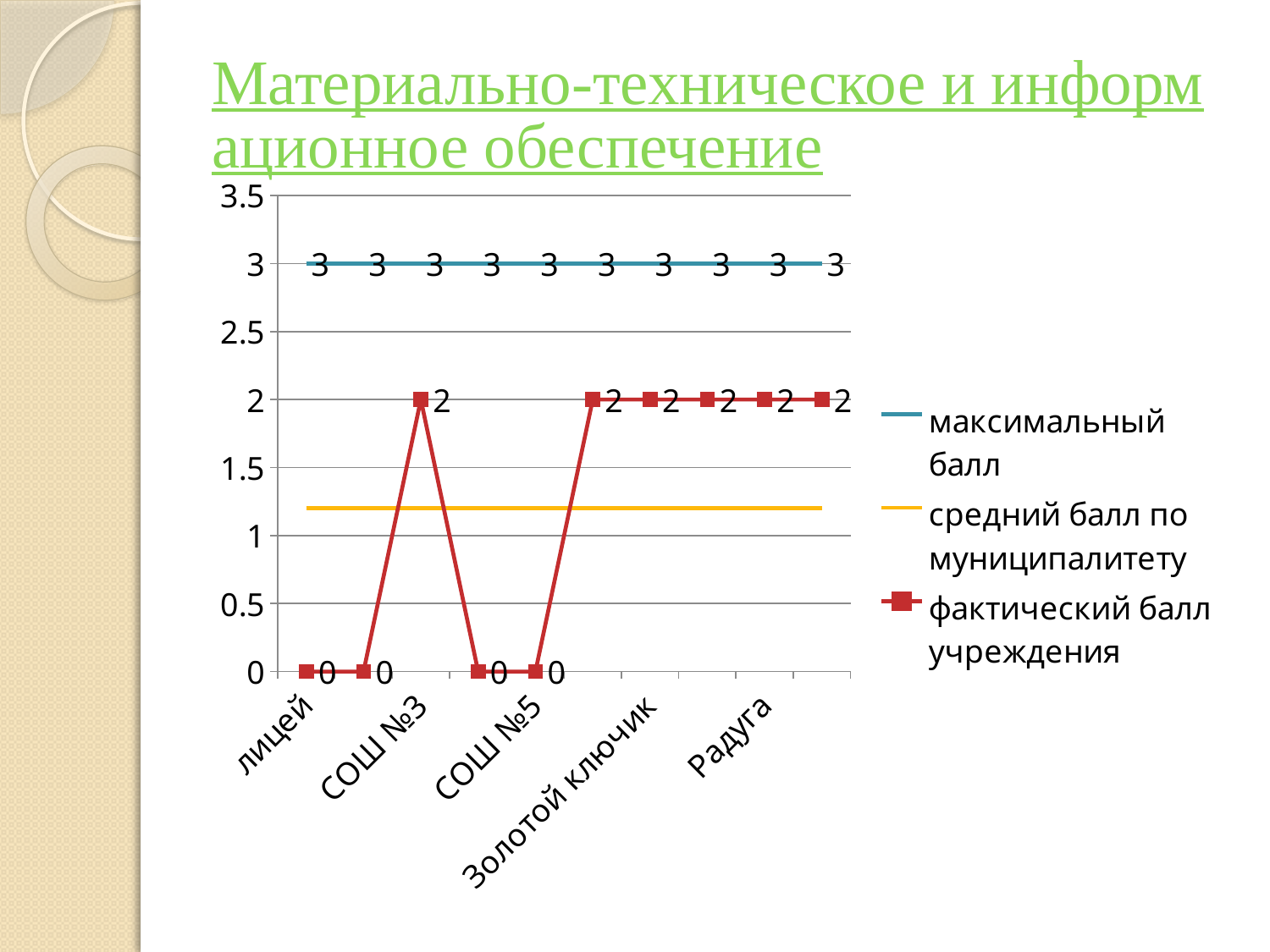
What is the difference between the максимальный балл and the фактический балл учреждения for СОШ №3? 1 What is the фактический балл учреждения for Золотой ключик? 2 What is the максимальный балл value shown for Радуга? 3 Is the средний балл по муниципалитету line greater or less than 1.5? less What is the фактический балл учреждения for лицей? 0 Is the средний балл по муниципалитету line greater or less than 1? greater How many series does the legend list? 3 What is the фактический балл учреждения for СОШ №5? 0 What is the фактический балл учреждения for СОШ №3? 2 What kind of chart is shown on the slide? line chart What colour is the фактический балл учреждения line in the legend? red Which has the higher фактический балл учреждения, СОШ №3 or СОШ №5? СОШ №3